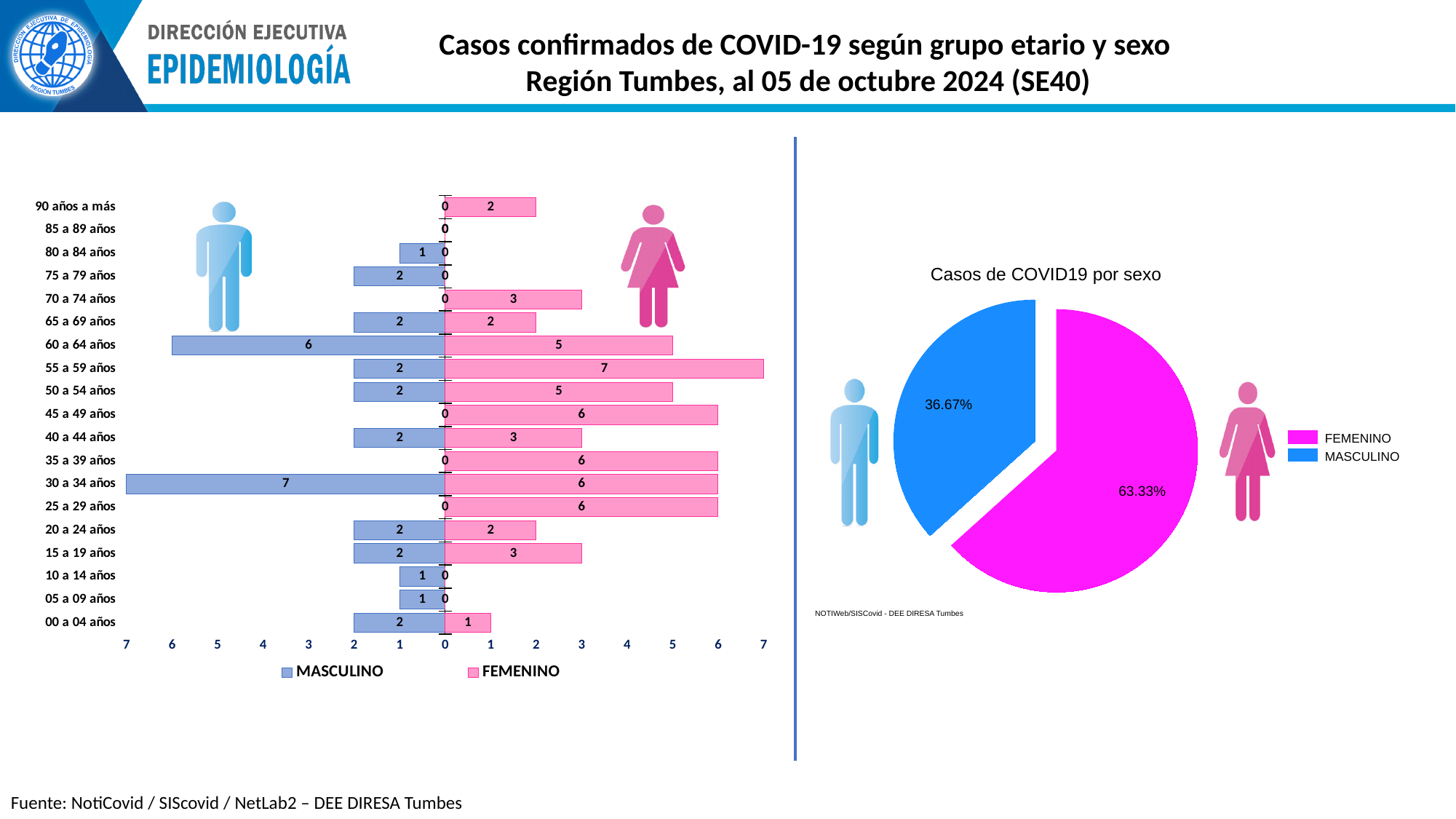
In the left bar chart, how many FEMENINO cases are in the 55 a 59 años group? 7 How many age groups are shown in the left bar chart? 19 In the left bar chart, how many MASCULINO cases are in the 30 a 34 años group? 7 What type of chart is 'Casos de COVID19 por sexo'? Pie chart In the left bar chart, what is the total of MASCULINO and FEMENINO cases in the 30 a 34 años group? 13 In the left bar chart, which age group has the highest number of MASCULINO cases? 30 a 34 años In the pie chart 'Casos de COVID19 por sexo', what share of cases is FEMENINO? 63.33% How many series does the legend of the left chart list? 2 In the left bar chart, which age group has the highest number of FEMENINO cases? 55 a 59 años In the left bar chart, how many FEMENINO cases are in the 60 a 64 años group? 5 In the left bar chart, which is larger in the 60 a 64 años group, MASCULINO or FEMENINO? MASCULINO In the left bar chart, what is the difference between FEMENINO and MASCULINO cases in the 45 a 49 años group? 6